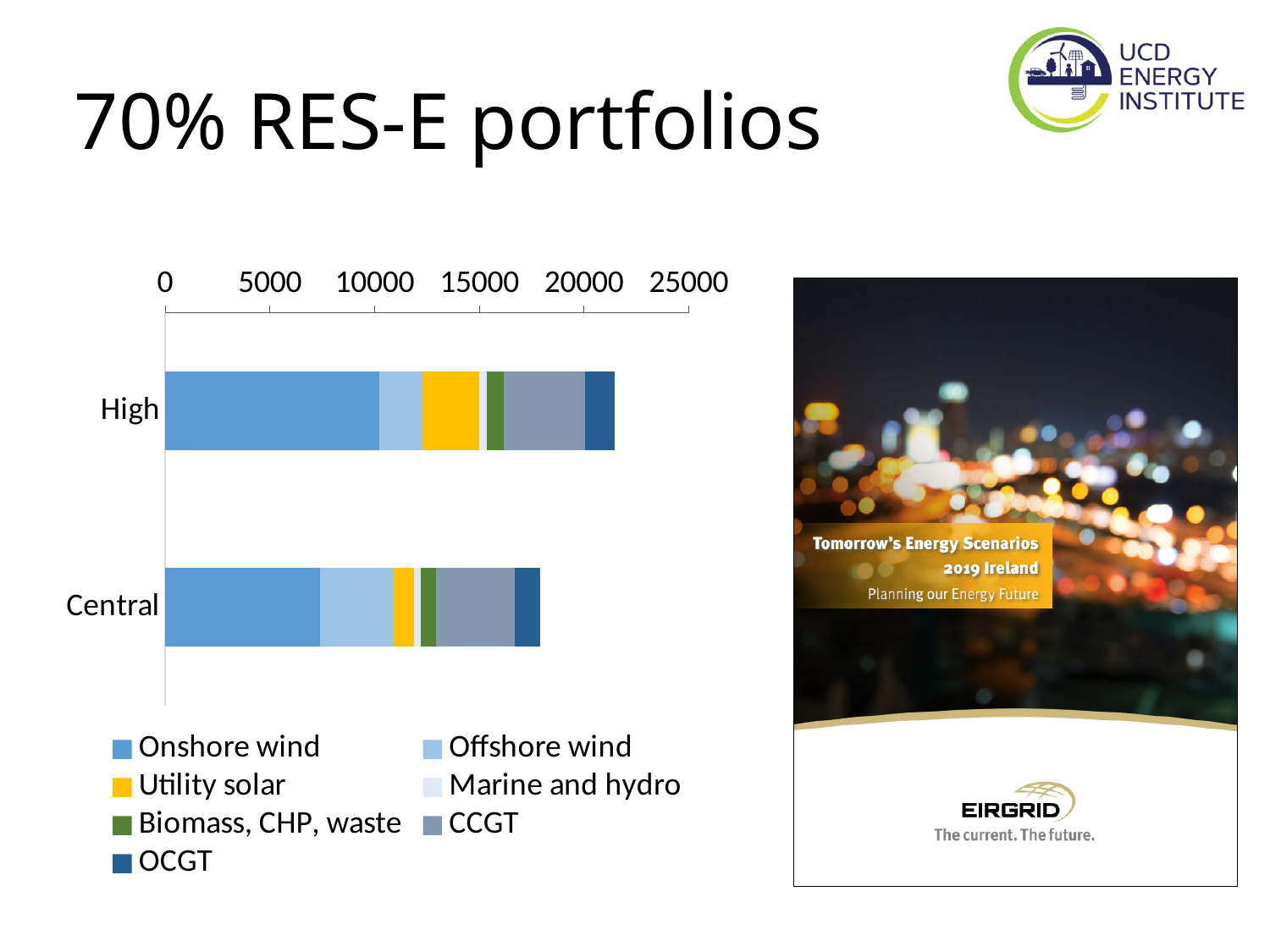
Is the Onshore wind value for Central greater or less than 10000? less How many series does the chart's legend list? 7 Which category has the longer total bar, High or Central? High What is the title of the slide containing the chart? 70% RES-E portfolios Which category has the larger Onshore wind segment, High or Central? High Which series is shown in yellow in the chart's legend? Utility solar Is the total value of the Central bar greater or less than 15000? greater Is the total value of the High bar greater or less than 20000? greater What kind of chart is shown on the slide? stacked bar chart Which category has the shorter total bar? Central How many categories (bars) does the chart show? 2